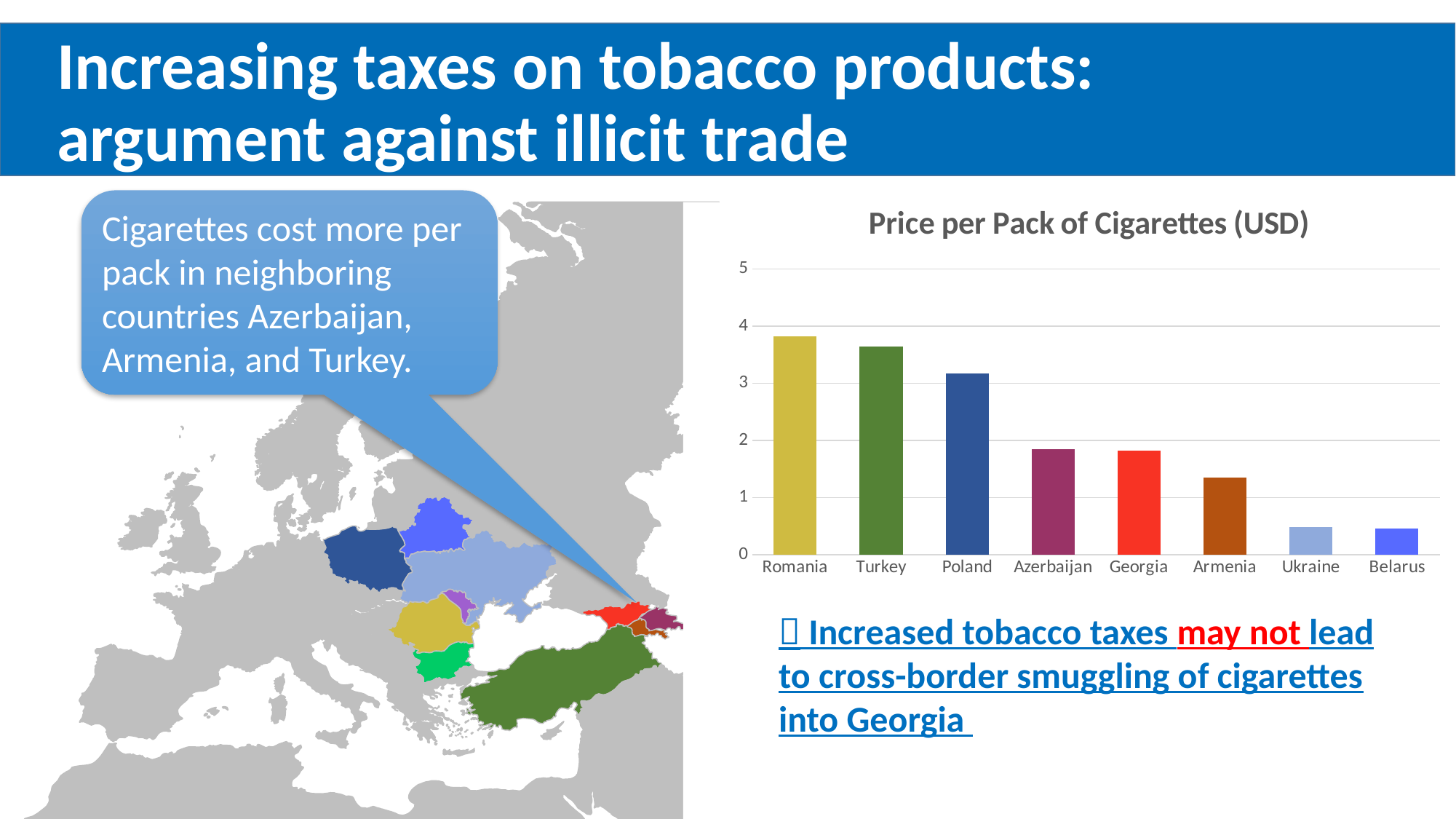
Is the value for Ukraine greater or less than 1? less How many countries are shown in the chart? 8 Is the value for Poland greater or less than 3? greater Do the values rise or fall from left to right across the chart? fall Is the value for Romania greater or less than 3? greater What kind of chart is shown on the slide? bar chart What is the title of the chart? Price per Pack of Cigarettes (USD) Which country has the highest price per pack of cigarettes? Romania Which has a higher price per pack, Turkey or Armenia? Turkey Which has a higher price per pack, Romania or Poland? Romania